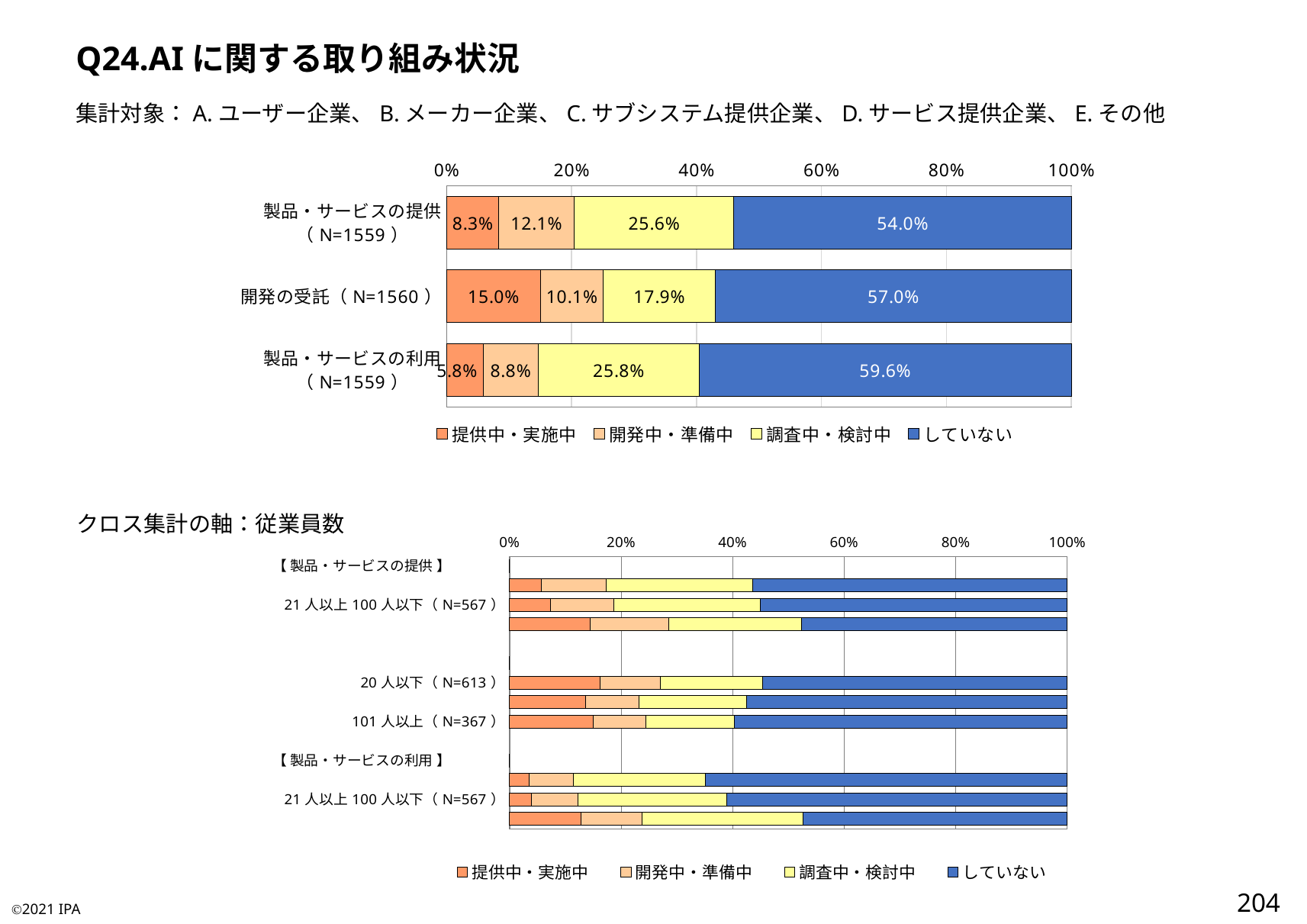
In the top chart, which category has the highest value for していない? 製品・サービスの利用 (N=1559) How many series does the legend of the top chart list? 4 In the bottom chart, is the 提供中・実施中 value for 20人以下 (N=613) greater or less than 20%? less In the top chart, which series is shown in blue? していない In the top chart, which category has the lowest value for 提供中・実施中? 製品・サービスの利用 (N=1559) In the top chart, what is the value of 提供中・実施中 for 開発の受託 (N=1560)? 15.0% In the top chart, which is larger: 開発中・準備中 for 製品・サービスの提供 or 開発中・準備中 for 開発の受託? 製品・サービスの提供 In the top chart, what is the value of していない for 製品・サービスの利用 (N=1559)? 59.6% In the top chart, what is the difference between the していない values for 開発の受託 and 製品・サービスの提供? 3.0% What kind of chart is the top chart? Stacked bar chart In the top chart, what is the value of 調査中・検討中 for 製品・サービスの提供 (N=1559)? 25.6% How many categories are shown in the top chart? 3